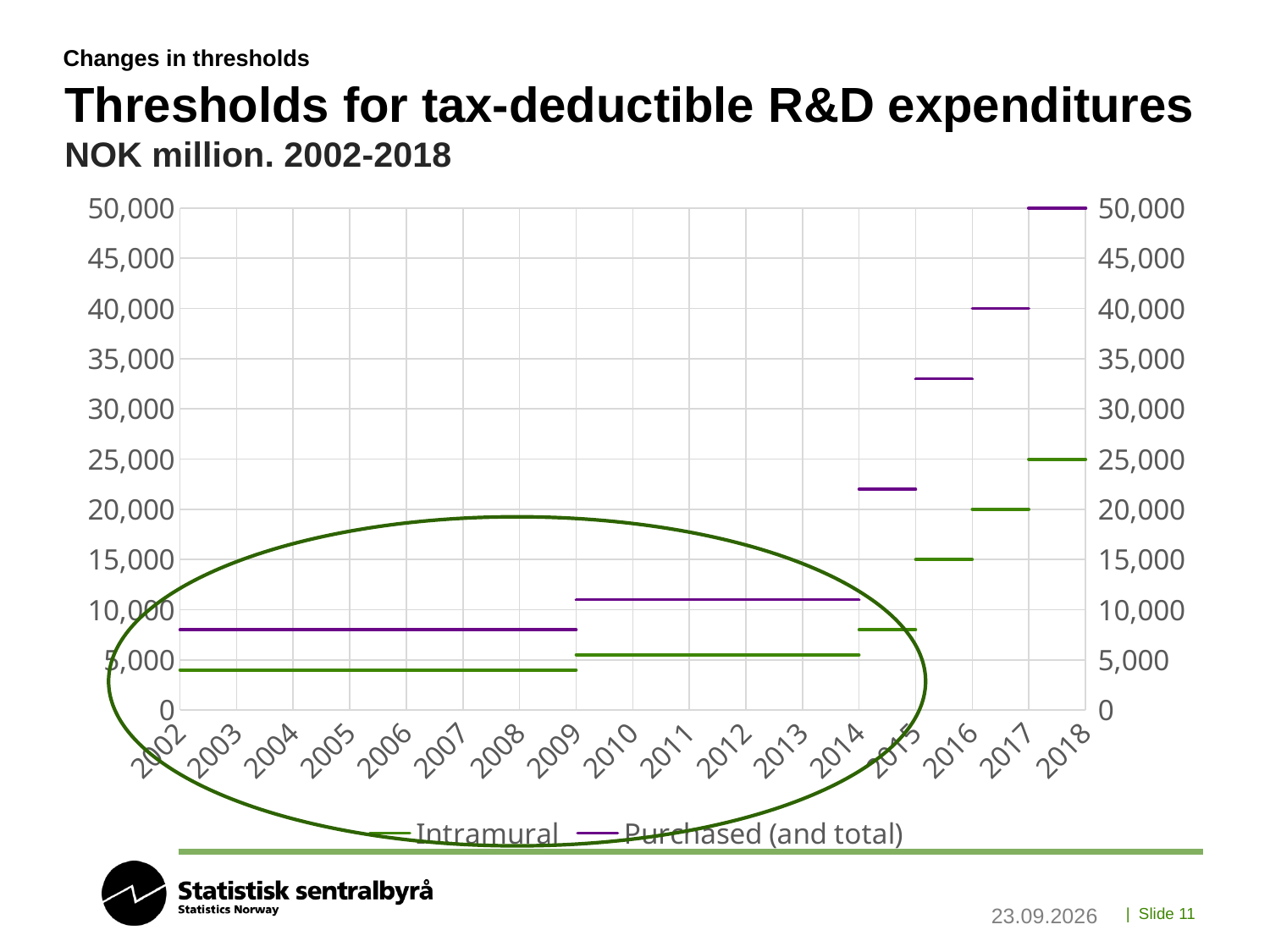
Is the Purchased (and total) threshold in 2014 greater or less than 20,000? greater What is the Purchased (and total) threshold in 2017? 50,000 What is the Intramural threshold in 2017? 25,000 What is the difference between the Purchased (and total) threshold and the Intramural threshold in 2017? 25,000 What is the Purchased (and total) threshold in 2016? 40,000 What is the Intramural threshold in 2016? 20,000 Is the Purchased (and total) threshold in 2002 greater or less than 10,000? less What are the two series named in the legend? Intramural; Purchased (and total) Do the threshold values rise or fall from 2002 to 2018? rise What is the Intramural threshold in 2015? 15,000 How many series does the legend list? 2 What kind of chart is shown on the slide? line chart